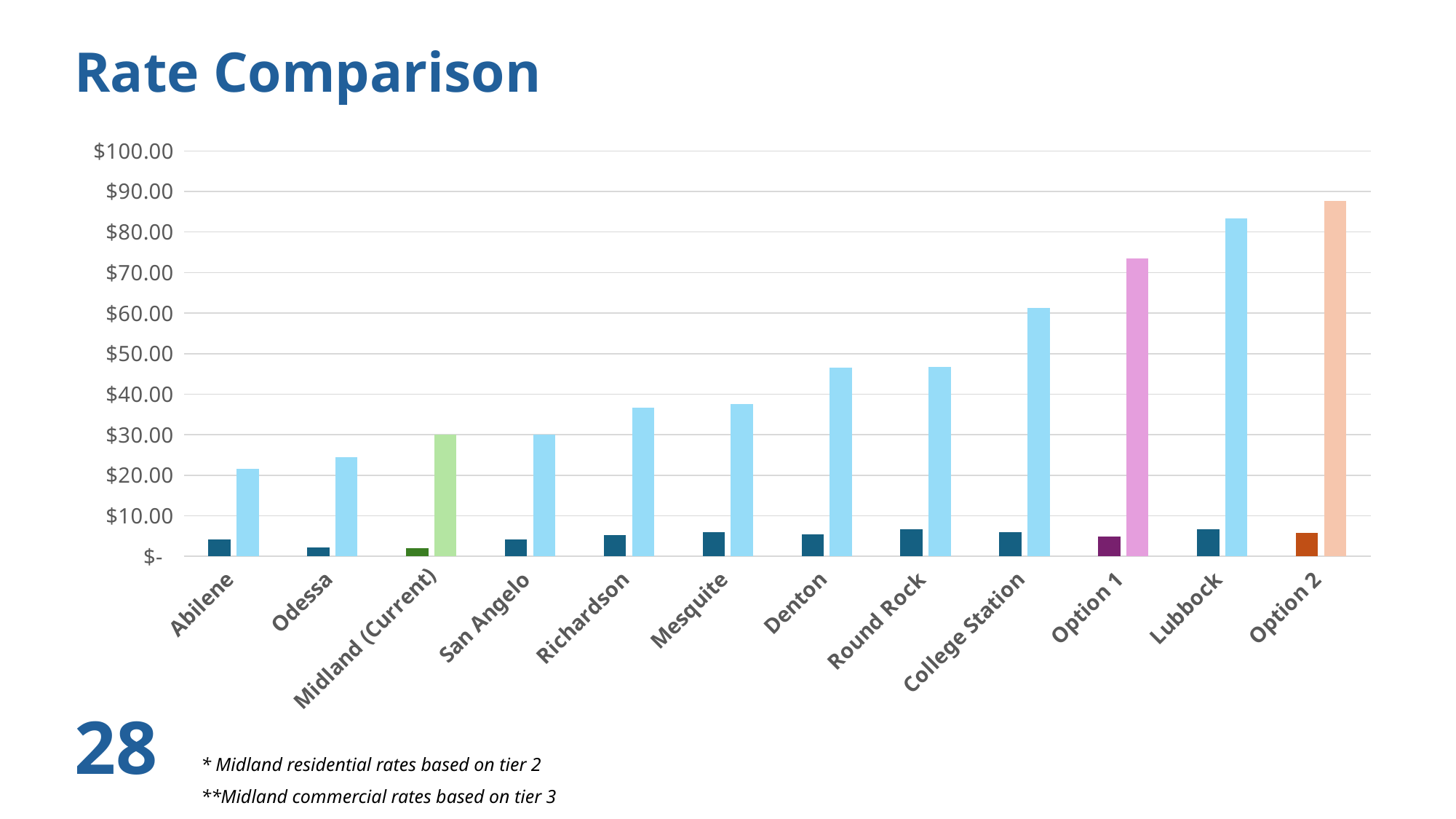
What kind of chart is shown on the slide? bar chart Which category has the highest taller bar in the chart? Option 2 What is the title of the chart? Rate Comparison Which category has the lowest taller bar in the chart? Abilene Is the taller bar for College Station greater or less than $50.00? greater What colour is the taller bar for Midland (Current)? green How many categories are shown along the x axis of the chart? 12 Do the taller bars generally rise or fall from left to right across the x axis? rise Is the taller bar for Abilene greater or less than $30.00? less Which has a higher taller bar, Lubbock or Denton? Lubbock Is the taller bar for Option 1 greater or less than $70.00? greater